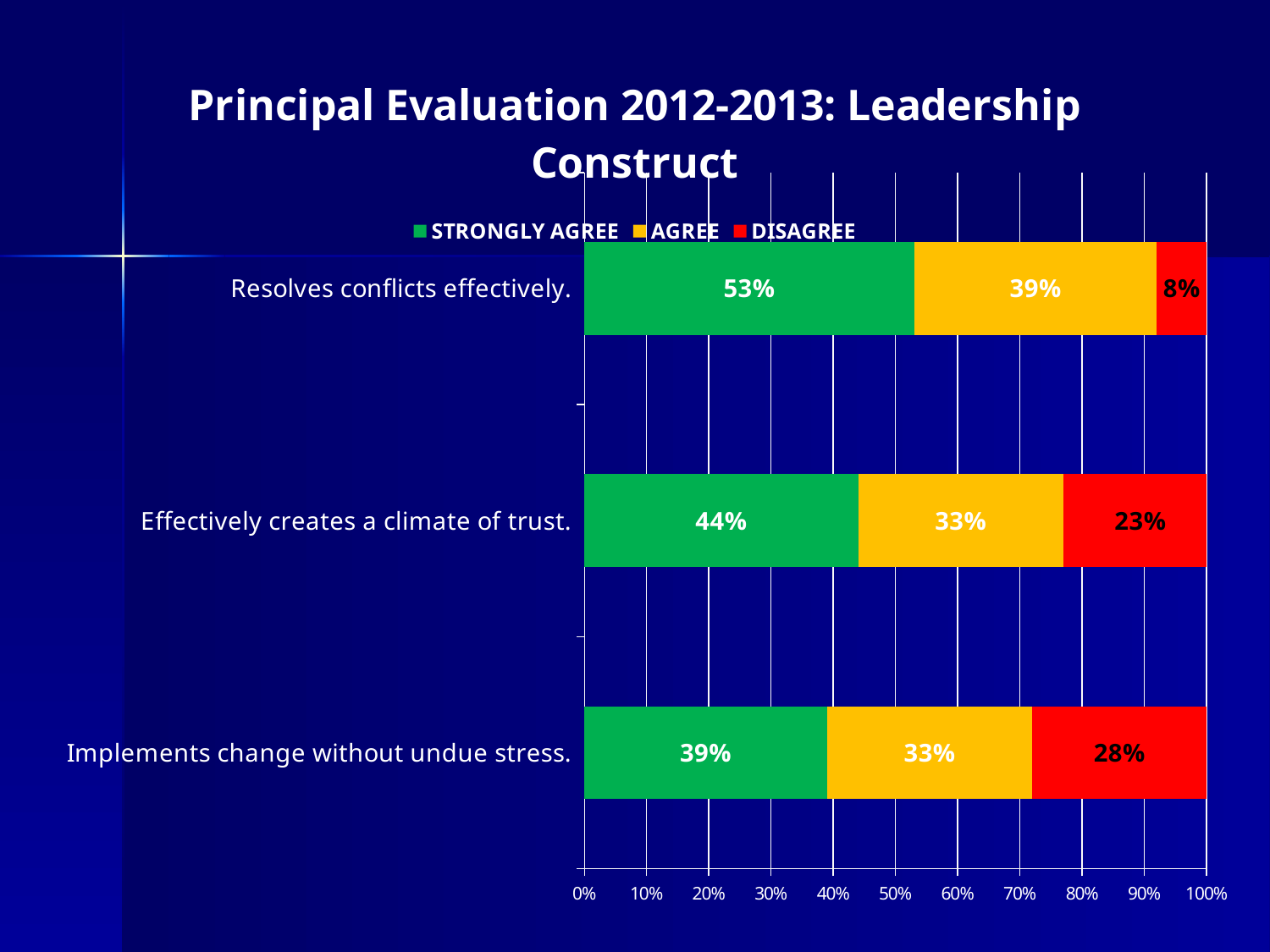
What is the combined Strongly Agree and Agree percentage for 'Resolves conflicts effectively.'? 92% What percentage disagree that the principal effectively creates a climate of trust? 23% What is the difference between the Disagree percentages for 'Implements change without undue stress.' and 'Resolves conflicts effectively.'? 20% Which statement has the highest Strongly Agree percentage? Resolves conflicts effectively. How many statements are shown on the chart? 3 How many series does the legend list? 3 What percentage agree that the principal implements change without undue stress? 33% Which statement has the lowest Disagree percentage? Resolves conflicts effectively. What percentage strongly agree that the principal resolves conflicts effectively? 53% What kind of chart is shown on the slide? Stacked bar chart What colour represents the Disagree series? Red Which is larger: the Strongly Agree percentage for 'Effectively creates a climate of trust.' or for 'Implements change without undue stress.'? Effectively creates a climate of trust.